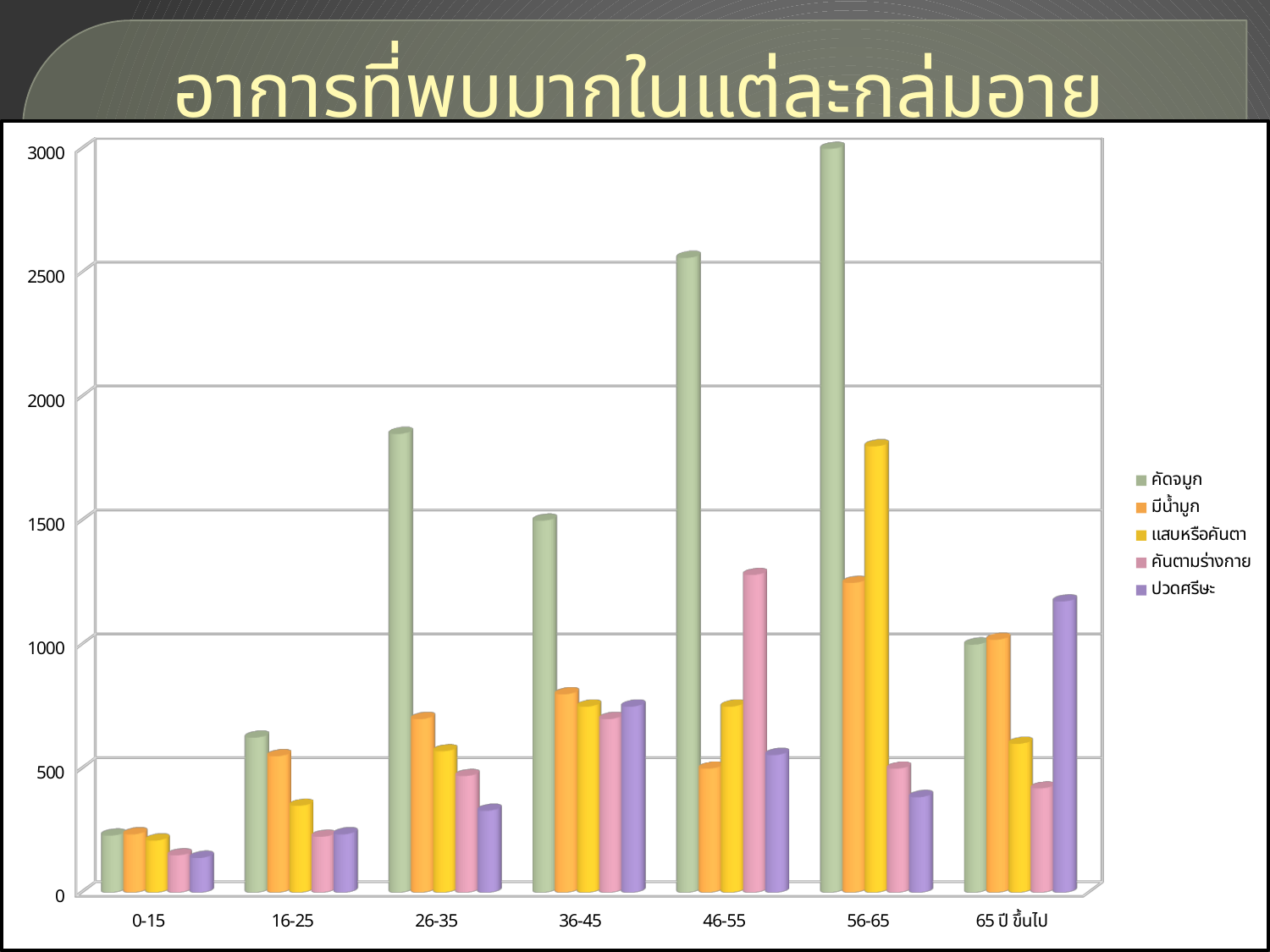
Is the value for คัดจมูก in the 46-55 group greater or less than 2000? greater What kind of chart is shown on the slide? bar chart How many age-group categories are shown on the x axis? 7 How many series does the legend list? 5 Which colour represents the คัดจมูก series in the legend? green Is the value for แสบหรือคันตา in the 56-65 group greater or less than 1500? greater Which age group has the highest value for คัดจมูก? 56-65 Which age group has the lowest value for คัดจมูก? 0-15 Is the value for คัดจมูก in the 26-35 group greater or less than 1500? greater In the 65 ปี ขึ้นไป group, which is larger: ปวดศรีษะ or คันตามร่างกาย? ปวดศรีษะ In the 46-55 group, which is larger: คันตามร่างกาย or ปวดศรีษะ? คันตามร่างกาย